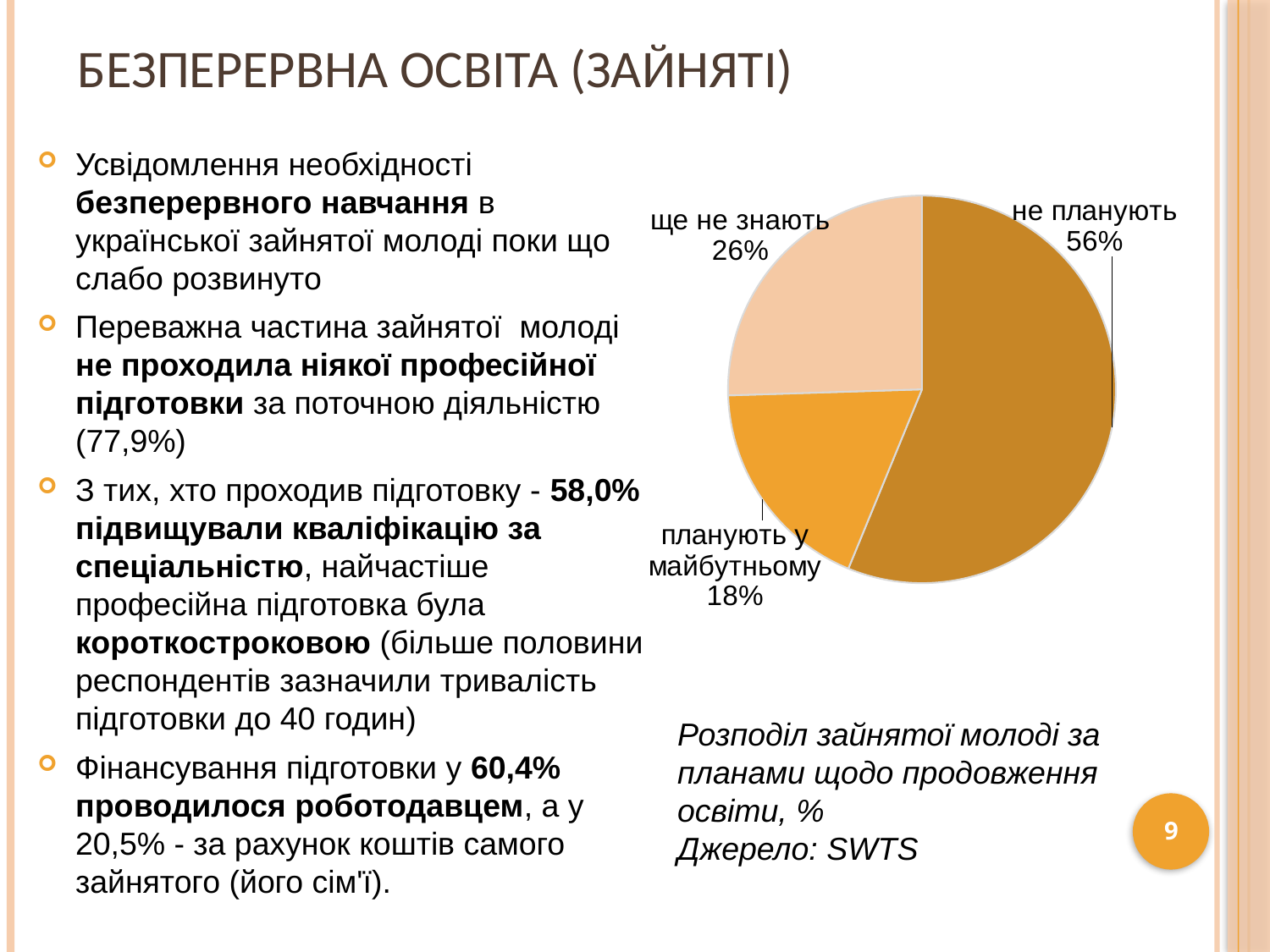
What is the difference in percentage points between "не планують" and "ще не знають"? 30 What share of employed youth do not plan to continue their education ("не планують")? 56% What is the difference in percentage points between "ще не знають" and "планують у майбутньому"? 8 What type of chart is shown on the slide? pie chart Which category has the largest slice of the pie? не планують What share of employed youth plan to continue education in the future ("планують у майбутньому")? 18% How many categories are shown in the pie chart? 3 Which category has the smallest slice of the pie? планують у майбутньому What share of employed youth do not yet know ("ще не знають") whether they will continue education? 26% What source is cited for the pie chart data? SWTS What is the combined share of "ще не знають" and "планують у майбутньому"? 44% Which is larger: the share for "ще не знають" or the share for "планують у майбутньому"? ще не знають